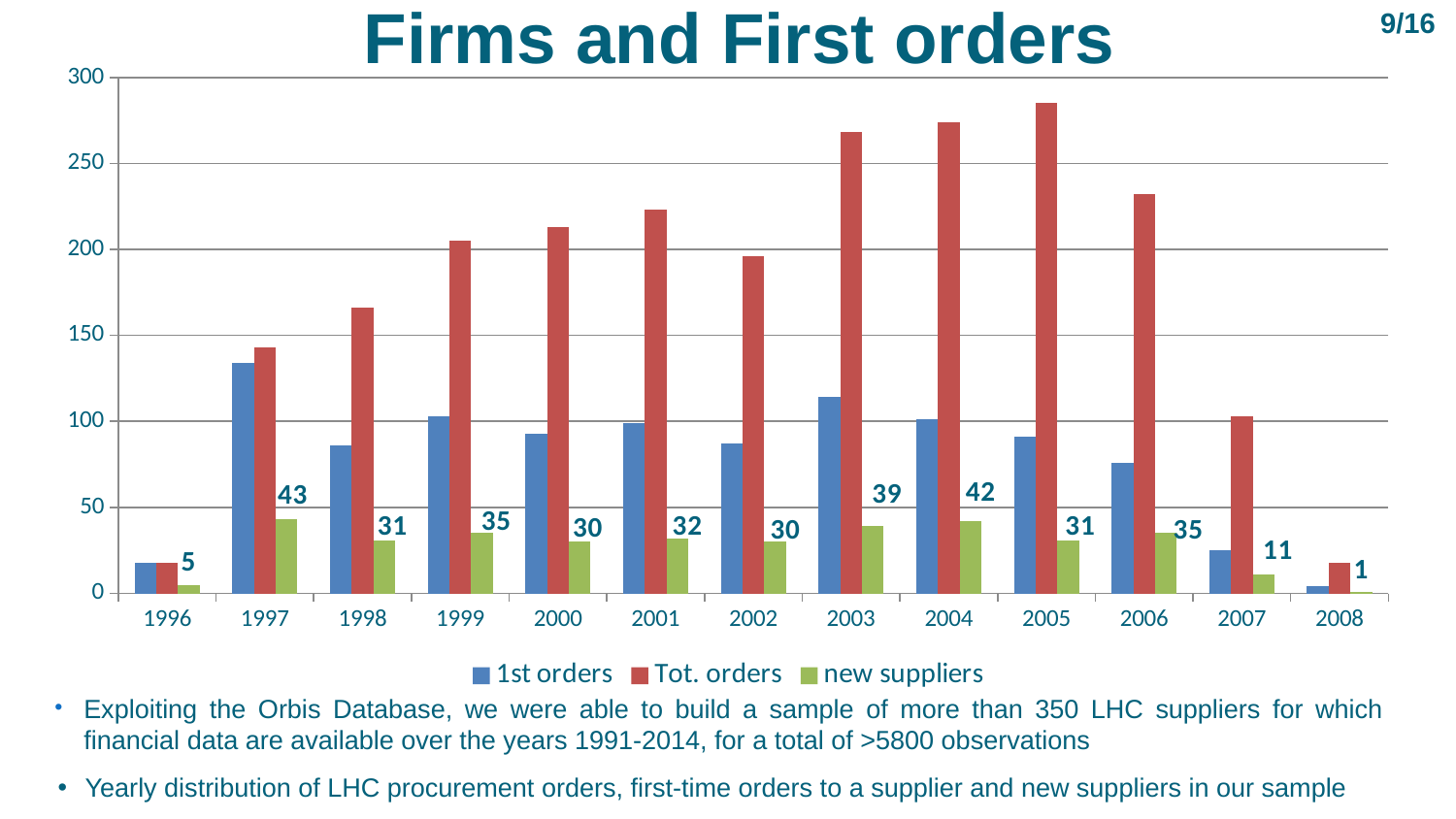
Which year has the lowest number of new suppliers? 2008 Is the value for Tot. orders in 2005 greater or less than 250? greater Which year has more new suppliers, 2003 or 2005? 2003 What is the value for new suppliers in 2008? 1 How many series does the legend list? 3 What is the value for new suppliers in 2004? 42 How many years are shown on the x axis? 13 Do Tot. orders rise or fall from 2005 to 2008? fall What is the difference between new suppliers in 1997 and in 2008? 42 What type of chart is shown on the slide? bar chart Which year has the highest number of new suppliers? 1997 What is the value for new suppliers in 1997? 43